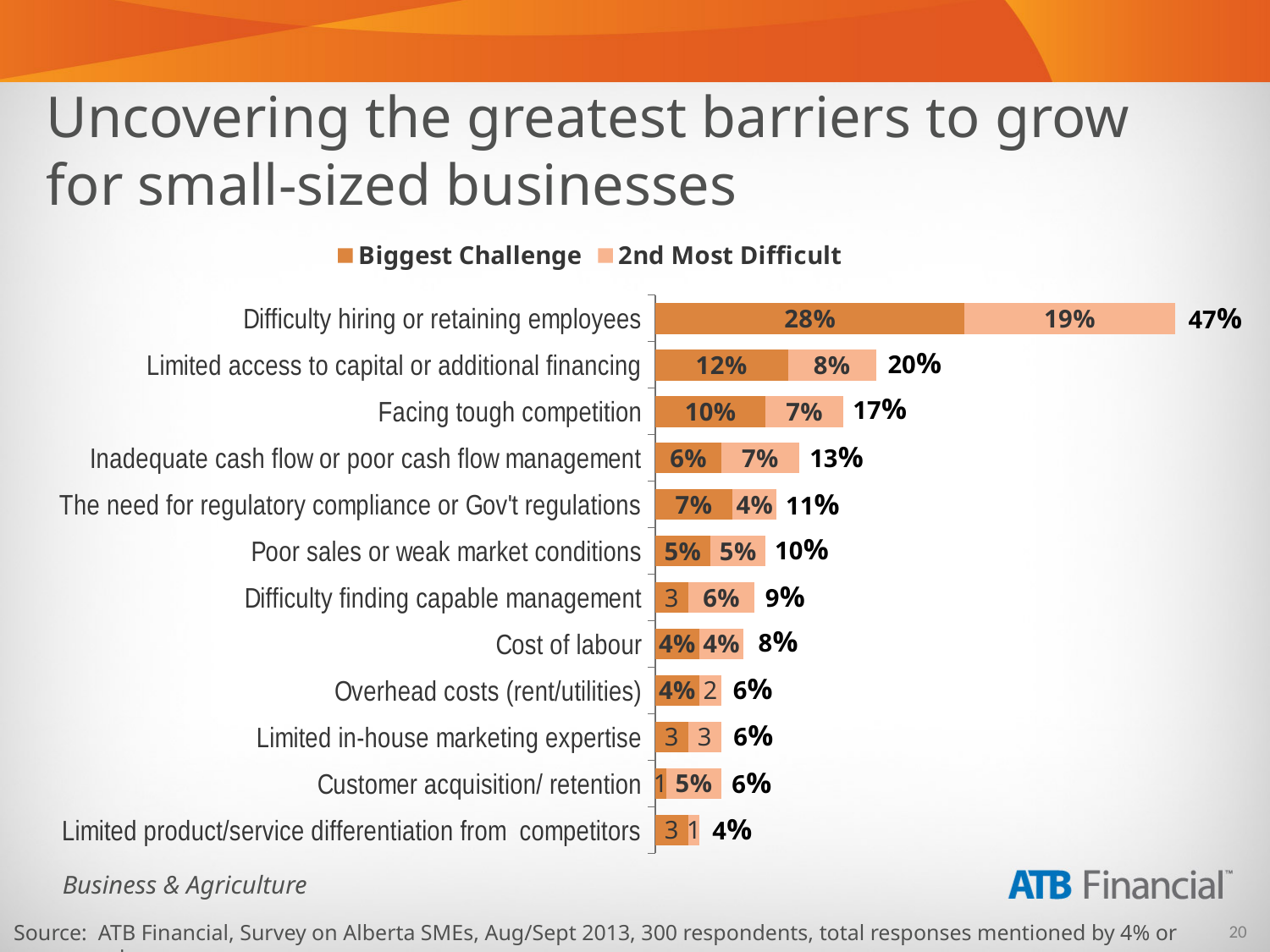
What is the '2nd Most Difficult' value for 'Customer acquisition/ retention'? 5% How many categories (barriers) are plotted in the chart? 12 What is the difference between the 'Biggest Challenge' and '2nd Most Difficult' values for 'Difficulty hiring or retaining employees'? 9% Which category has the highest total? Difficulty hiring or retaining employees How many series does the legend list? 2 Which category has the lowest total? Limited product/service differentiation from competitors What is the 'Biggest Challenge' value for 'Difficulty hiring or retaining employees'? 28% What is the total for the 'Facing tough competition' bar? 17% Which is larger for 'Inadequate cash flow or poor cash flow management': the 'Biggest Challenge' value or the '2nd Most Difficult' value? 2nd Most Difficult Which series is shown in the darker orange colour? Biggest Challenge What is the '2nd Most Difficult' value for 'Limited access to capital or additional financing'? 8% What kind of chart is shown on the slide? Stacked bar chart